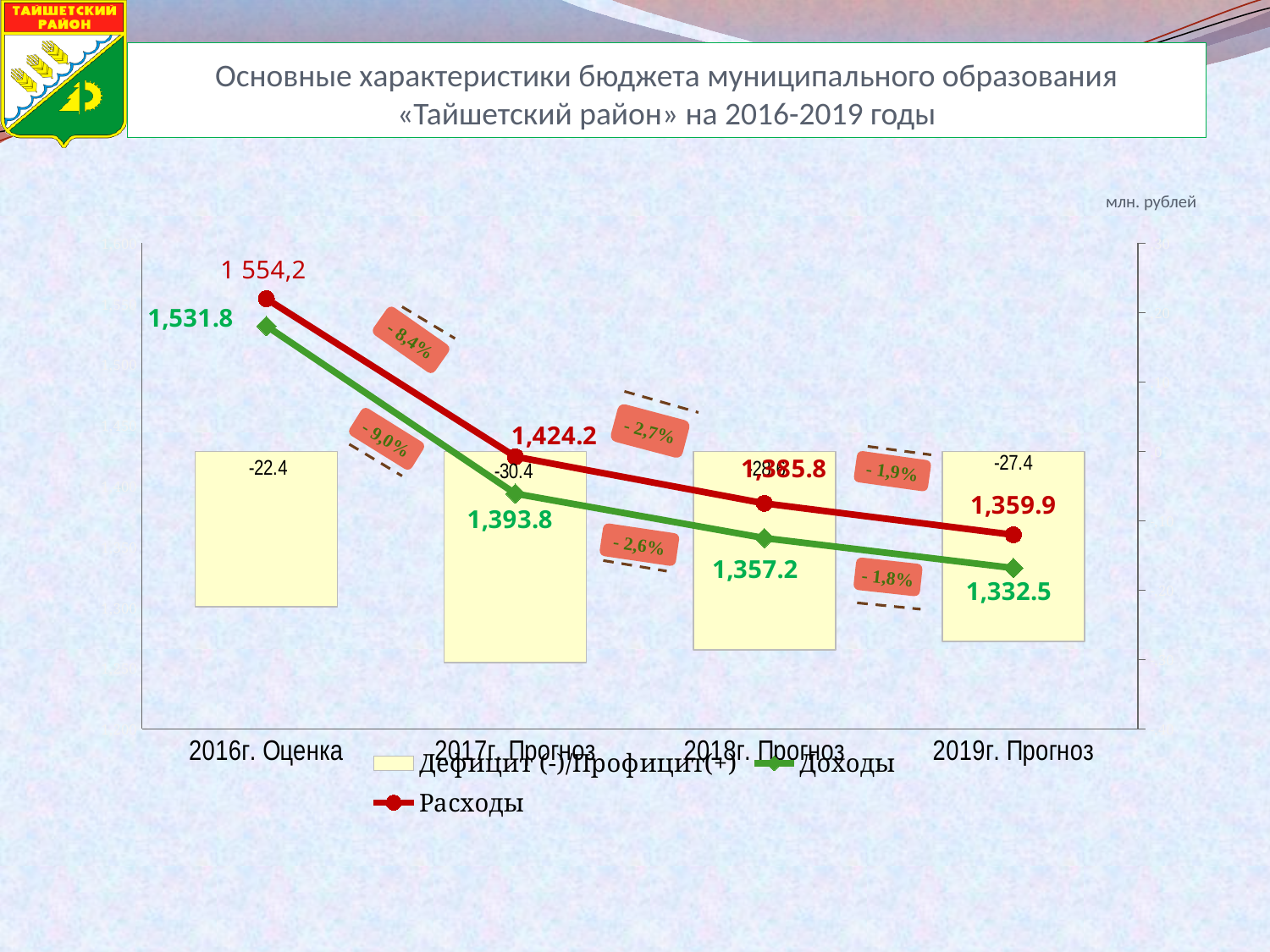
What is the value of Расходы for 2019г. Прогноз? 1,359.9 How many periods are shown on the x axis? 4 What is the value of Доходы for 2016г. Оценка? 1,531.8 What is the value of Расходы for 2017г. Прогноз? 1,424.2 Which is larger for 2017г. Прогноз, Расходы or Доходы? Расходы What is the value of Дефицит (-)/Профицит(+) for 2016г. Оценка? -22.4 What is the value of Дефицит (-)/Профицит(+) for 2017г. Прогноз? -30.4 In which period is Доходы highest? 2016г. Оценка Do the Доходы values rise or fall from 2016г. Оценка to 2019г. Прогноз? fall What is the value of Доходы for 2019г. Прогноз? 1,332.5 How many series does the legend list? 3 In which period is Доходы lowest? 2019г. Прогноз